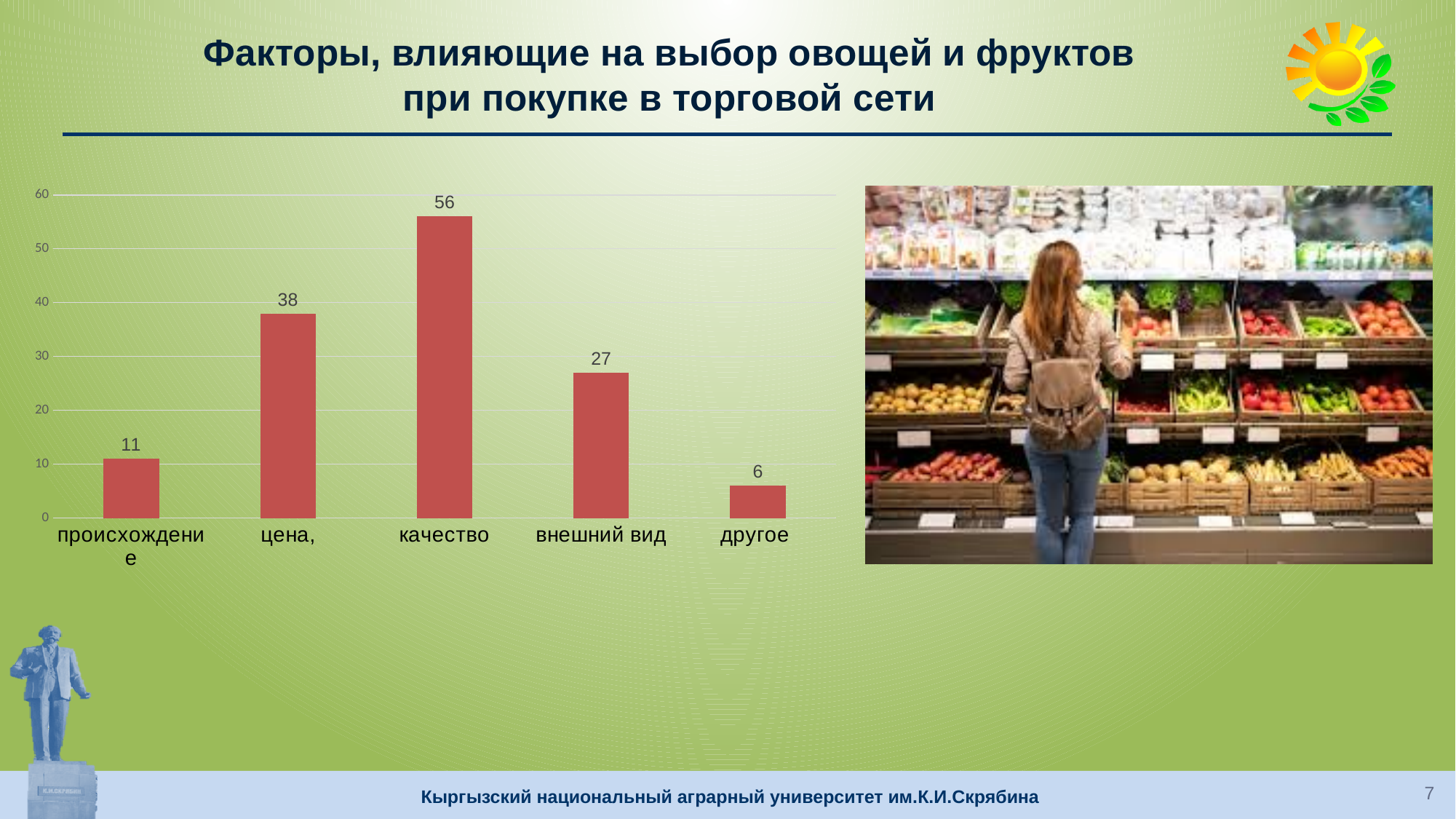
Is the value for цена greater or less than 40? less What kind of chart is shown on the slide? bar chart How many categories are shown in the chart? 5 What is the value for внешний вид? 27 What is the value for другое? 6 What is the value for качество? 56 Which category has the lowest value? другое What is the difference between the values for качество and цена? 18 What is the value for цена? 38 Which category has the highest value? качество What is the value for происхождение? 11 Which is larger, the value for внешний вид or the value for происхождение? внешний вид